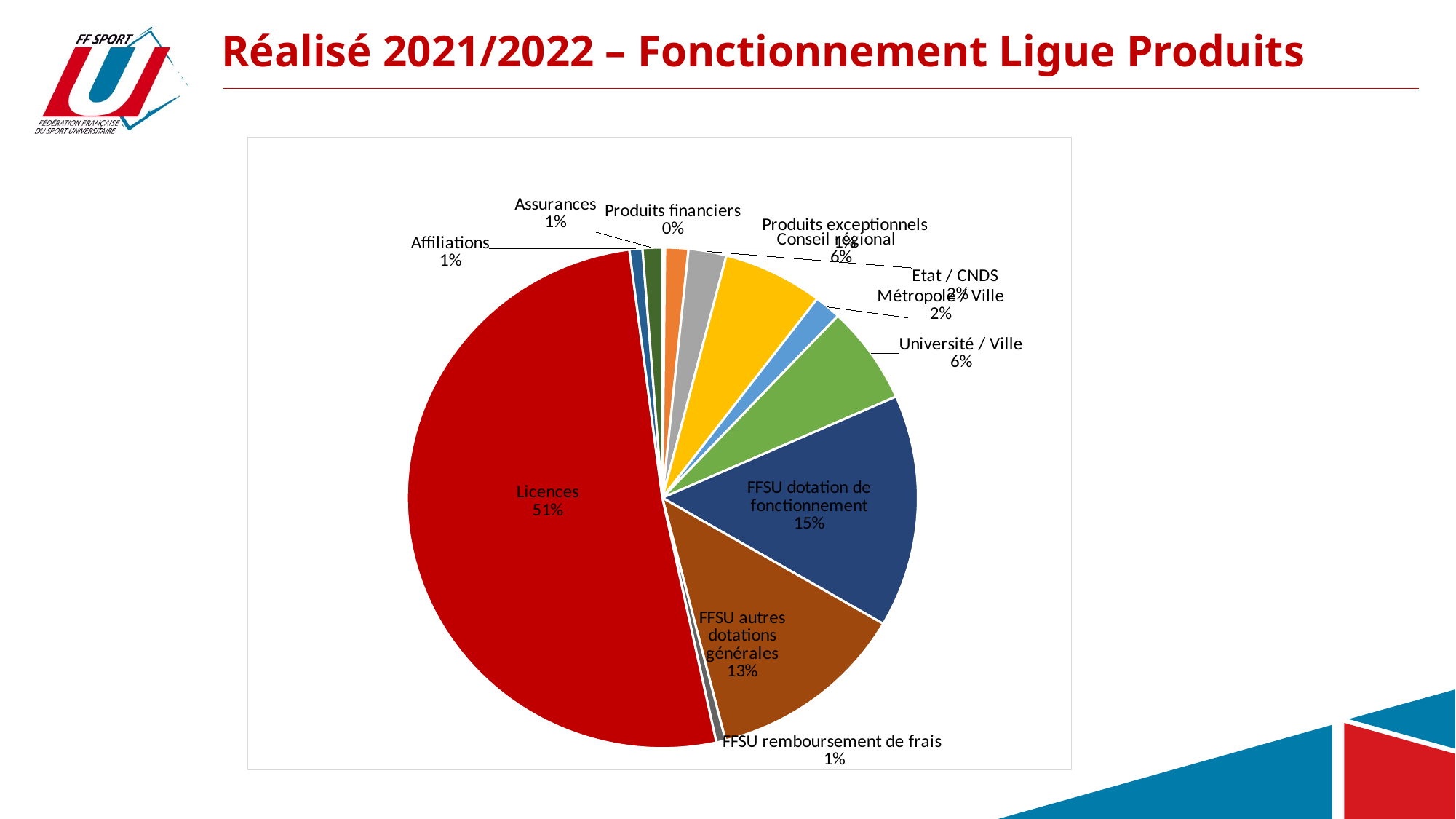
What is the value for FFSU autres dotations générales? 13% Which category has the largest slice of the pie? Licences What is the value for Produits financiers? 0% What is the value for FFSU dotation de fonctionnement? 15% What kind of chart is shown on the slide? pie chart What is the difference between the Licences share and the FFSU dotation de fonctionnement share? 36% What is the value for Conseil régional? 6% What share of the pie does Licences represent? 51% What is the value for FFSU remboursement de frais? 1% What is the value for Université / Ville? 6% What is the title of the slide containing the chart? Réalisé 2021/2022 – Fonctionnement Ligue Produits Which is larger, FFSU dotation de fonctionnement or FFSU autres dotations générales? FFSU dotation de fonctionnement